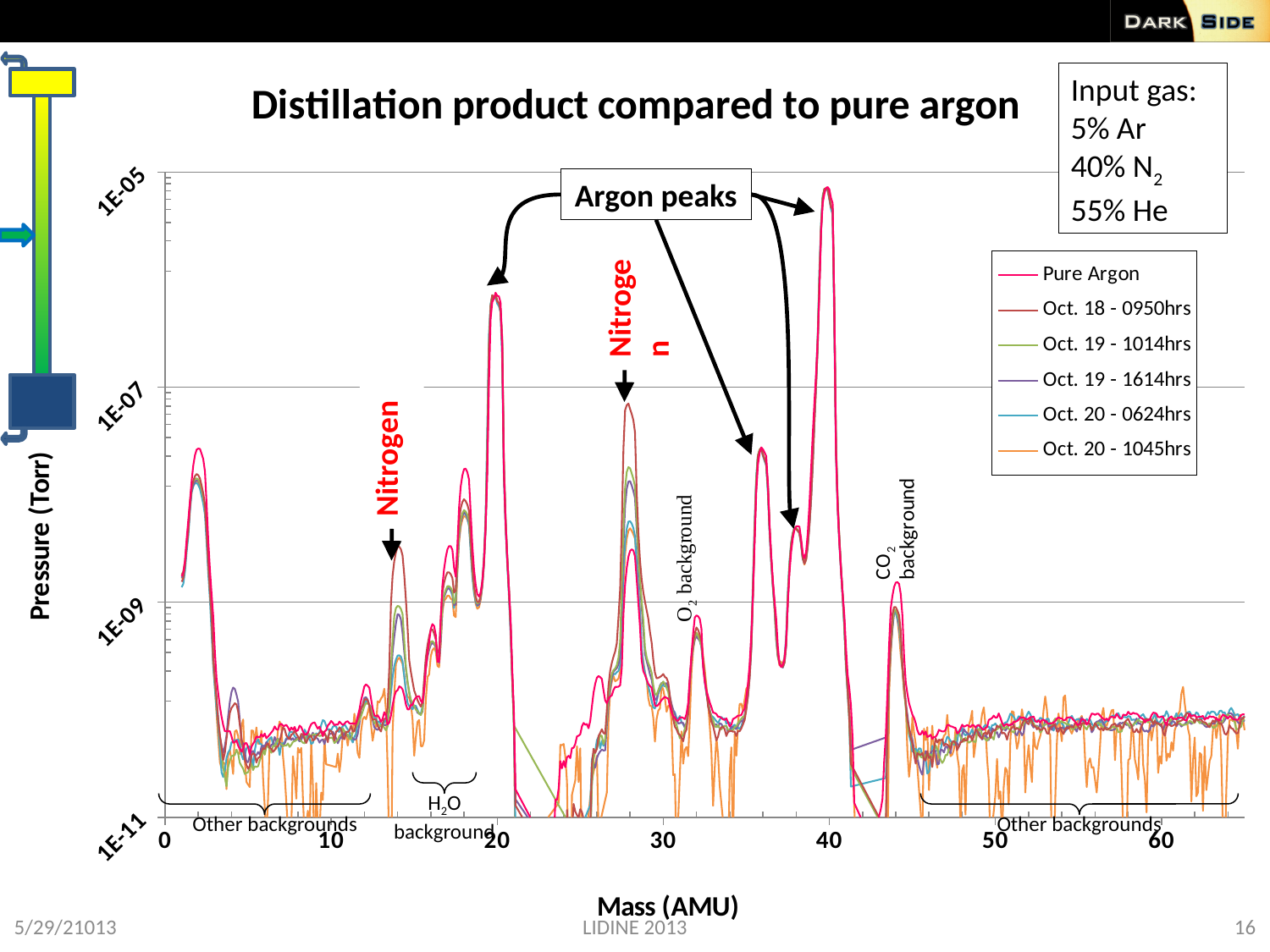
Is the peak value at 40 AMU greater or less than 1E-07? greater What kind of chart is shown on the slide? line chart At which mass (AMU) do the curves reach their highest peak? 40 Is the Pure Argon value at 28 AMU greater or less than 1E-07? less Is the baseline value of the curves between 50 and 60 AMU greater or less than 1E-09? less Which peak is larger, the one near 2 AMU or the one at 20 AMU? 20 AMU How many series does the legend list? 6 Which peak is larger, the one at 20 AMU or the one at 40 AMU? 40 AMU What is the label of the y axis? Pressure (Torr) What is the title of the chart? Distillation product compared to pure argon